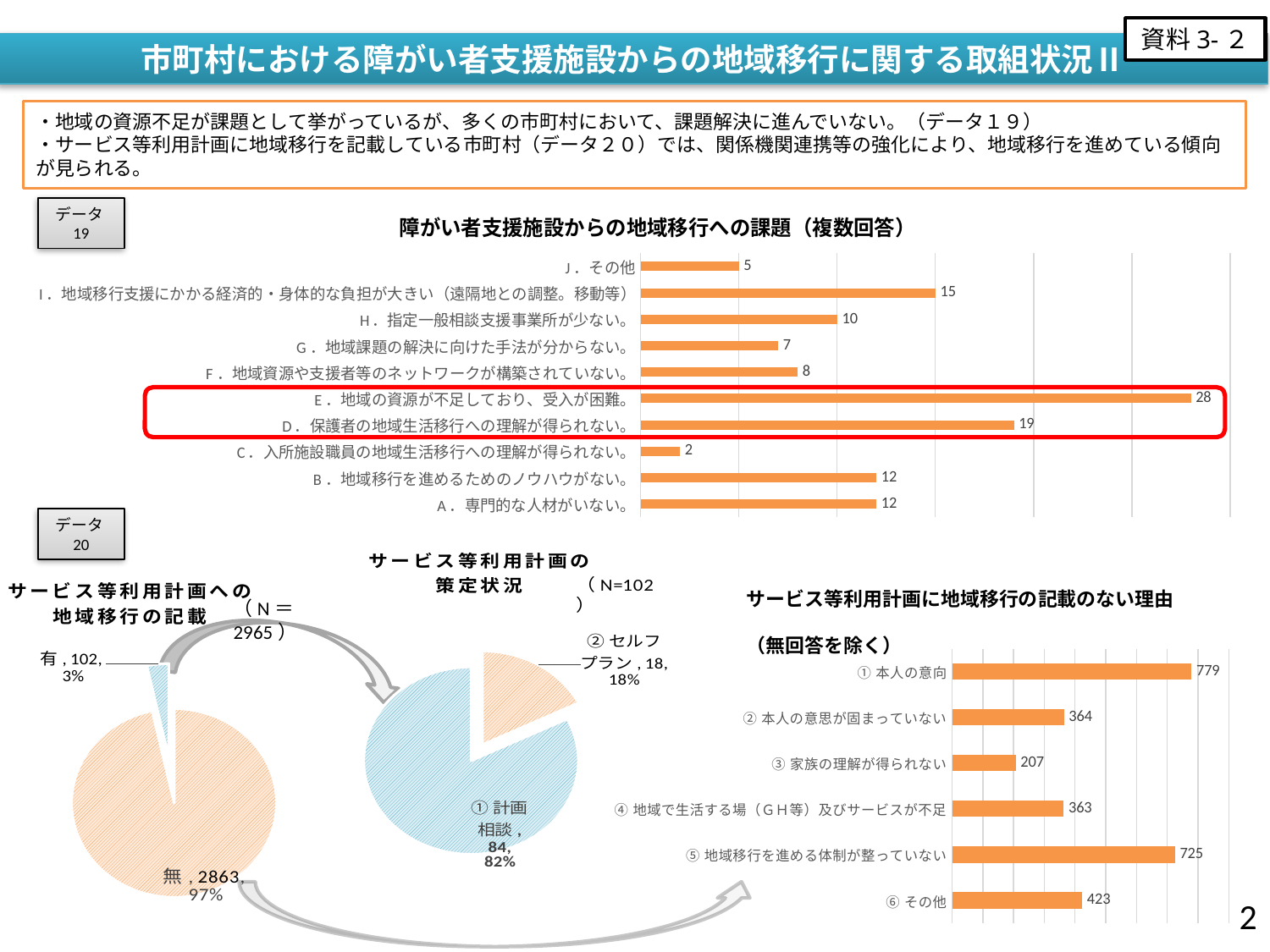
In the chart titled 障がい者支援施設からの地域移行への課題（複数回答）, what is the difference between the values for E and D? 9 In the pie chart titled サービス等利用計画への地域移行の記載, what is the value for 有? 102 In the chart titled サービス等利用計画に地域移行の記載のない理由（無回答を除く）, what is the difference between the values for ① 本人の意向 and ③ 家族の理解が得られない? 572 In the pie chart titled サービス等利用計画への地域移行の記載, what share does 無 have? 97% What kind of chart is the chart titled 障がい者支援施設からの地域移行への課題（複数回答）? bar chart In the pie chart titled サービス等利用計画の策定状況, what share does ② セルフプラン have? 18% In the chart titled 障がい者支援施設からの地域移行への課題（複数回答）, what is the value for E．地域の資源が不足しており、受入が困難。? 28 In the chart titled 障がい者支援施設からの地域移行への課題（複数回答）, which is larger: the value for H．指定一般相談支援事業所が少ない。 or the value for G．地域課題の解決に向けた手法が分からない。? H．指定一般相談支援事業所が少ない。 In the chart titled 障がい者支援施設からの地域移行への課題（複数回答）, which category has the lowest value? C．入所施設職員の地域生活移行への理解が得られない。 In the chart titled サービス等利用計画に地域移行の記載のない理由（無回答を除く）, which category has the highest value? ① 本人の意向 In the chart titled サービス等利用計画に地域移行の記載のない理由（無回答を除く）, what is the value for ⑤ 地域移行を進める体制が整っていない? 725 In the chart titled 障がい者支援施設からの地域移行への課題（複数回答）, how many categories are plotted? 10